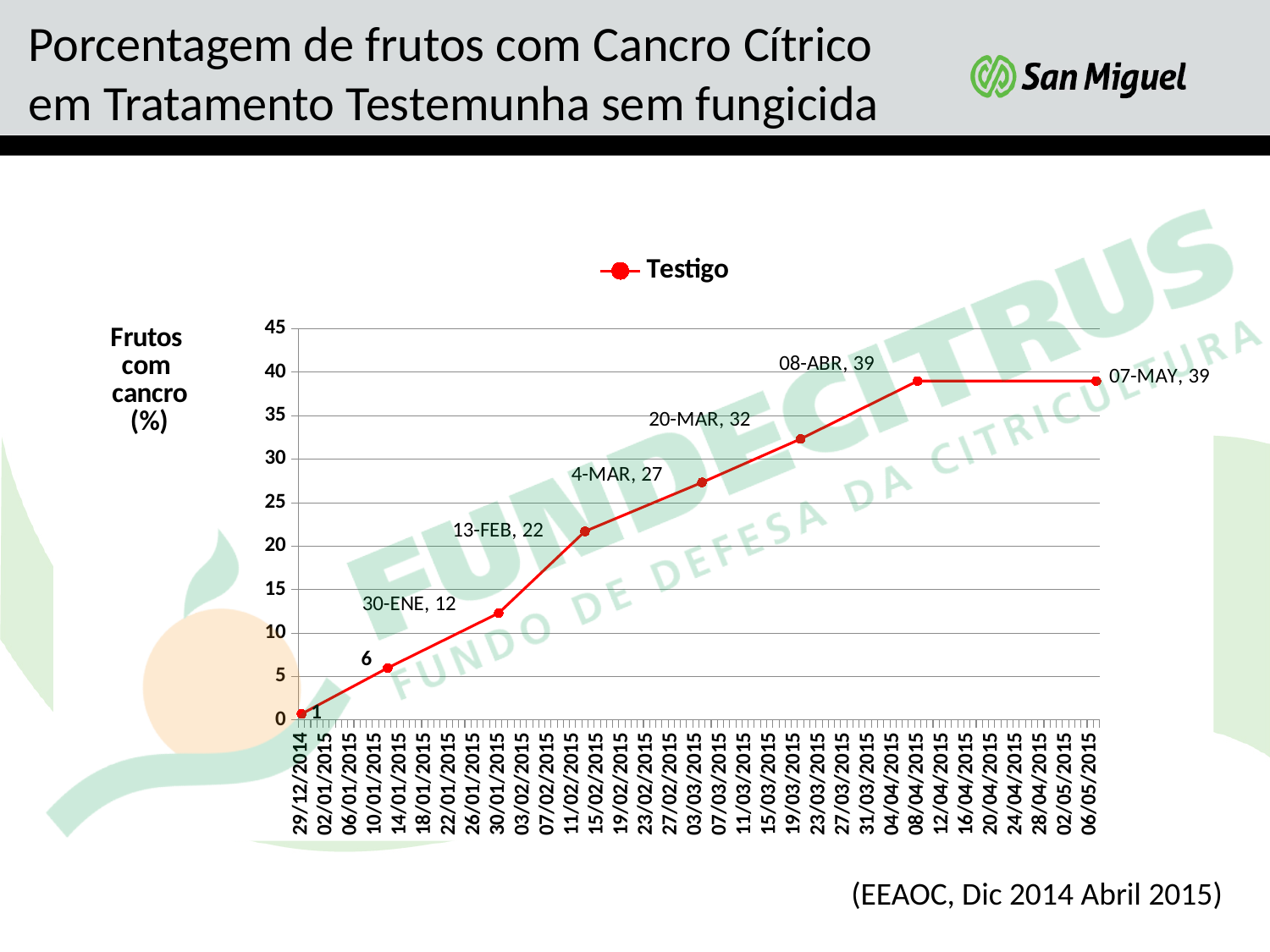
What is the value labelled for 20-MAR? 32 How many series does the legend list? 1 What is the label of the vertical axis? Frutos com cancro (%) What is the value labelled for 30-ENE? 12 What is the name of the series shown in the legend? Testigo Do the values generally rise or fall along the x axis? rise Which is larger, the value labelled for 13-FEB or the value labelled for 30-ENE? 13-FEB What is the difference between the values labelled for 20-MAR and 4-MAR? 5 What is the value labelled for 4-MAR? 27 What type of chart is shown on the slide? line chart What is the value labelled for 08-ABR? 39 What is the value labelled for 13-FEB? 22